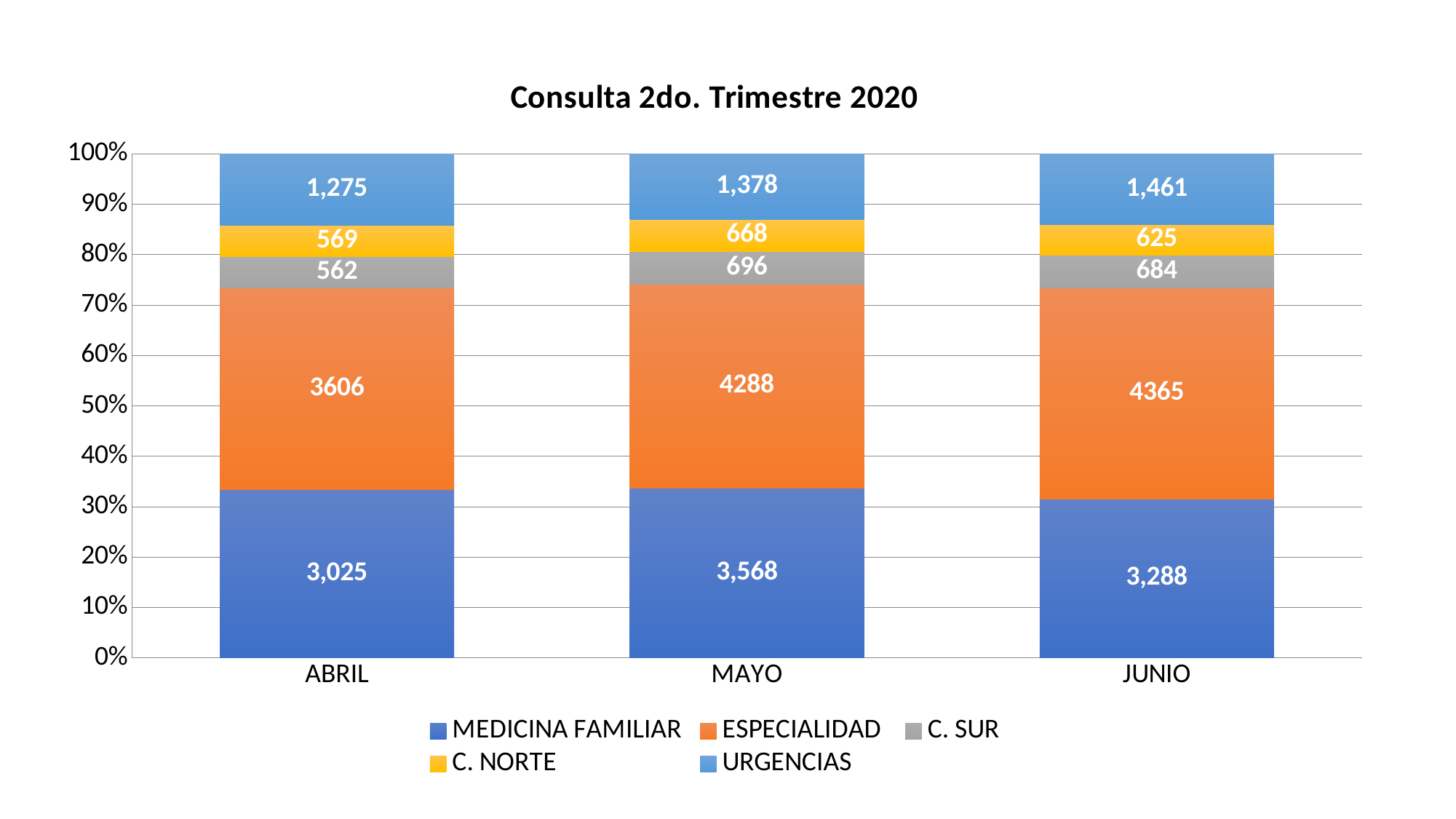
Which is larger in JUNIO: C. SUR or C. NORTE? C. SUR In which month is the C. NORTE value lowest? ABRIL How many months are shown on the x axis? 3 How many series does the legend list? 5 What is the value for MEDICINA FAMILIAR in ABRIL? 3,025 What is the difference between the ESPECIALIDAD values for JUNIO and ABRIL? 759 What is the value for ESPECIALIDAD in MAYO? 4288 What kind of chart is this? Stacked bar chart What is the value for C. SUR in MAYO? 696 What is the value for URGENCIAS in JUNIO? 1,461 In which month is the ESPECIALIDAD value highest? JUNIO Do the URGENCIAS values rise or fall from ABRIL to JUNIO? Rise